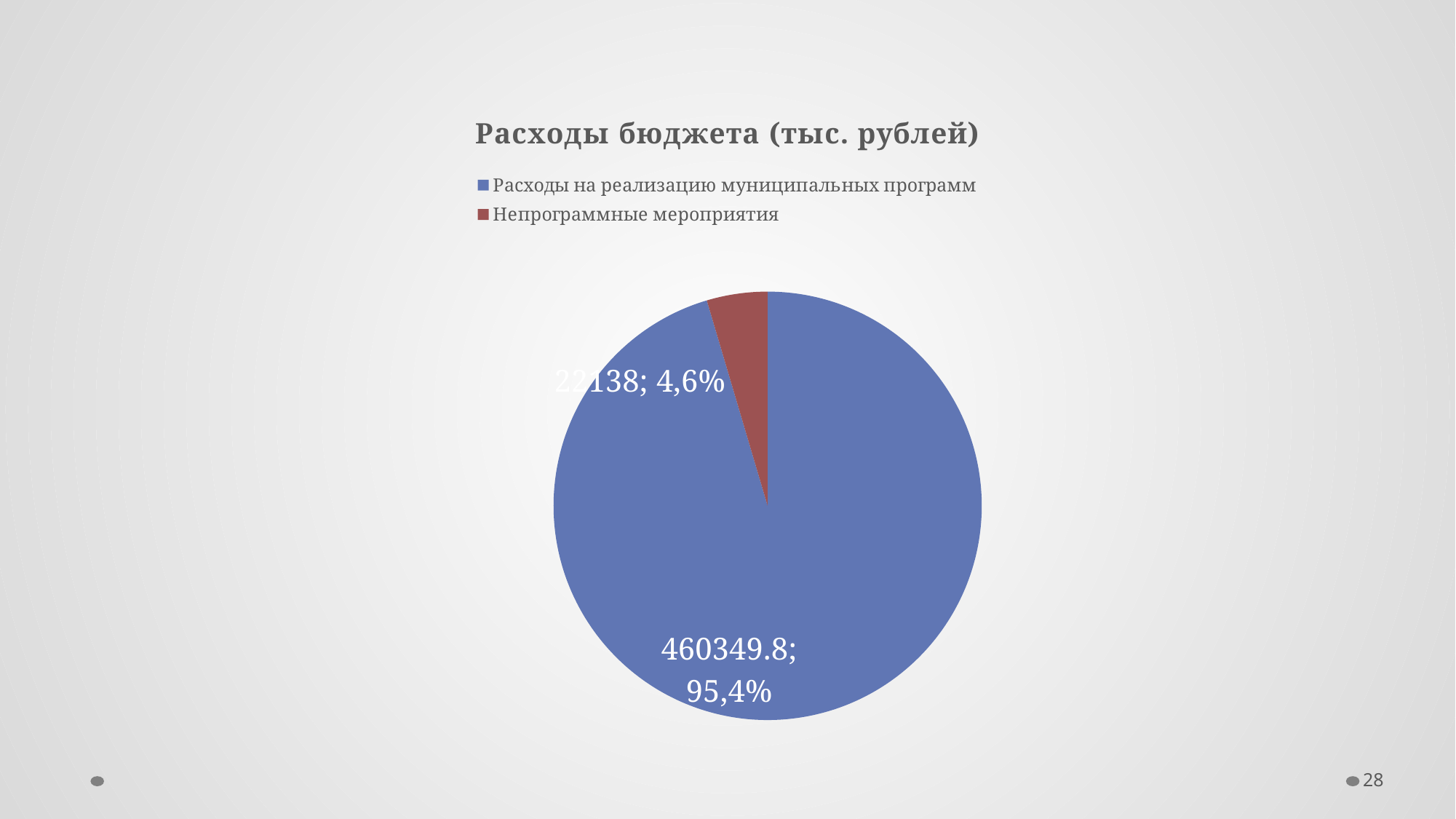
Which category has the smallest slice of the pie? Непрограммные мероприятия How many categories are shown in the pie chart? 2 What is the title of the chart? Расходы бюджета (тыс. рублей) What share of the pie does Расходы на реализацию муниципальных программ represent? 95,4% What colour is the slice for Непрограммные мероприятия? Red What is the value for Непрограммные мероприятия? 22138 What kind of chart is shown on the slide? Pie chart What is the value for Расходы на реализацию муниципальных программ? 460349.8 Which is larger: Расходы на реализацию муниципальных программ or Непрограммные мероприятия? Расходы на реализацию муниципальных программ What is the difference between the values for Расходы на реализацию муниципальных программ and Непрограммные мероприятия? 438211.8 Which category has the largest slice of the pie? Расходы на реализацию муниципальных программ What share of the pie does Непрограммные мероприятия represent? 4,6%